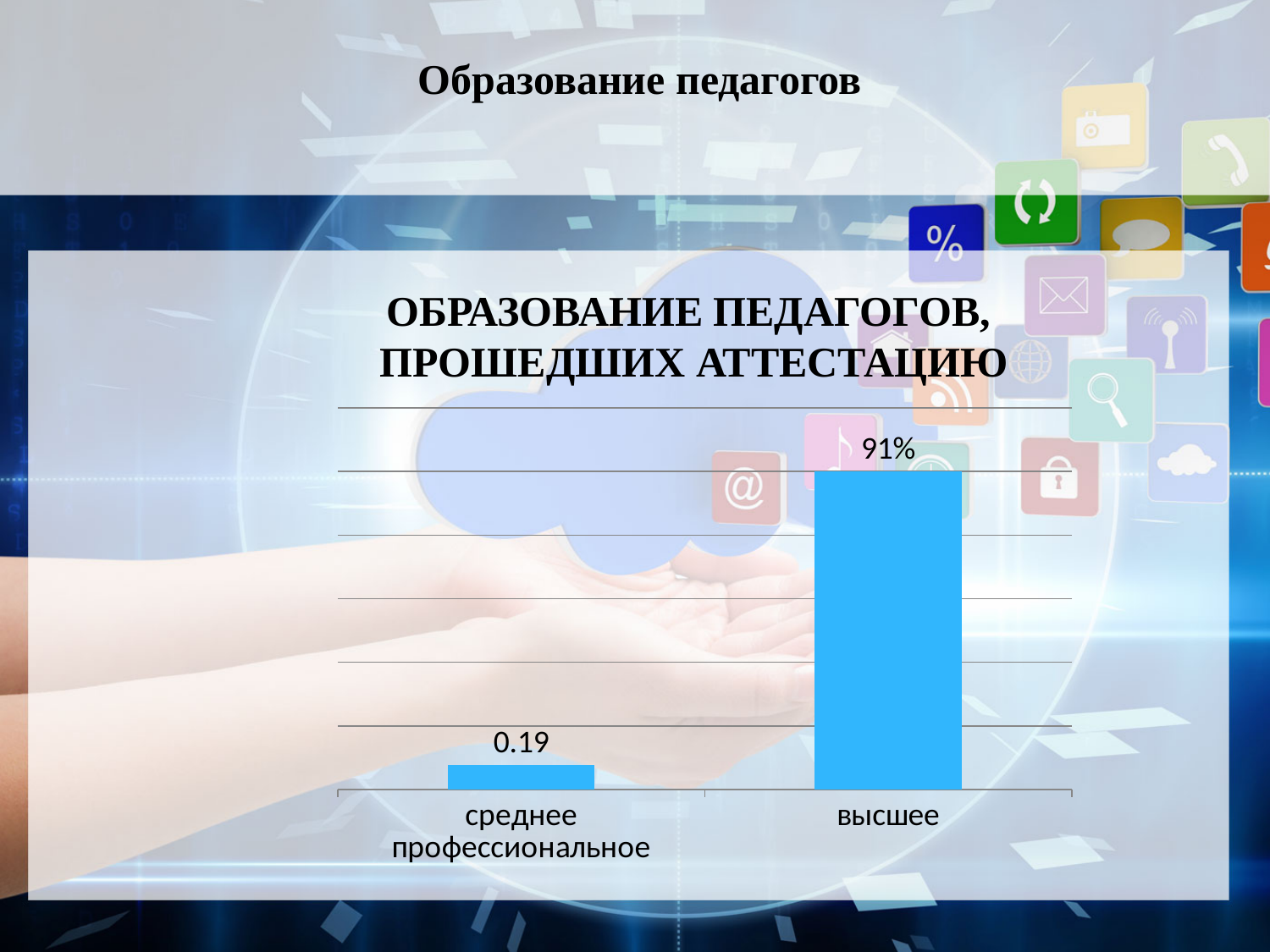
Which category has the highest bar? высшее Which category has the lowest bar? среднее профессиональное What value is shown for the category "высшее"? 91% Which is larger: the bar for "высшее" or the bar for "среднее профессиональное"? высшее What is the title of the chart? ОБРАЗОВАНИЕ ПЕДАГОГОВ, ПРОШЕДШИХ АТТЕСТАЦИЮ What colour are the bars in the chart? blue How many categories are shown in the chart? 2 What type of chart is shown on the slide? bar chart What value is shown for the category "среднее профессиональное"? 0.19